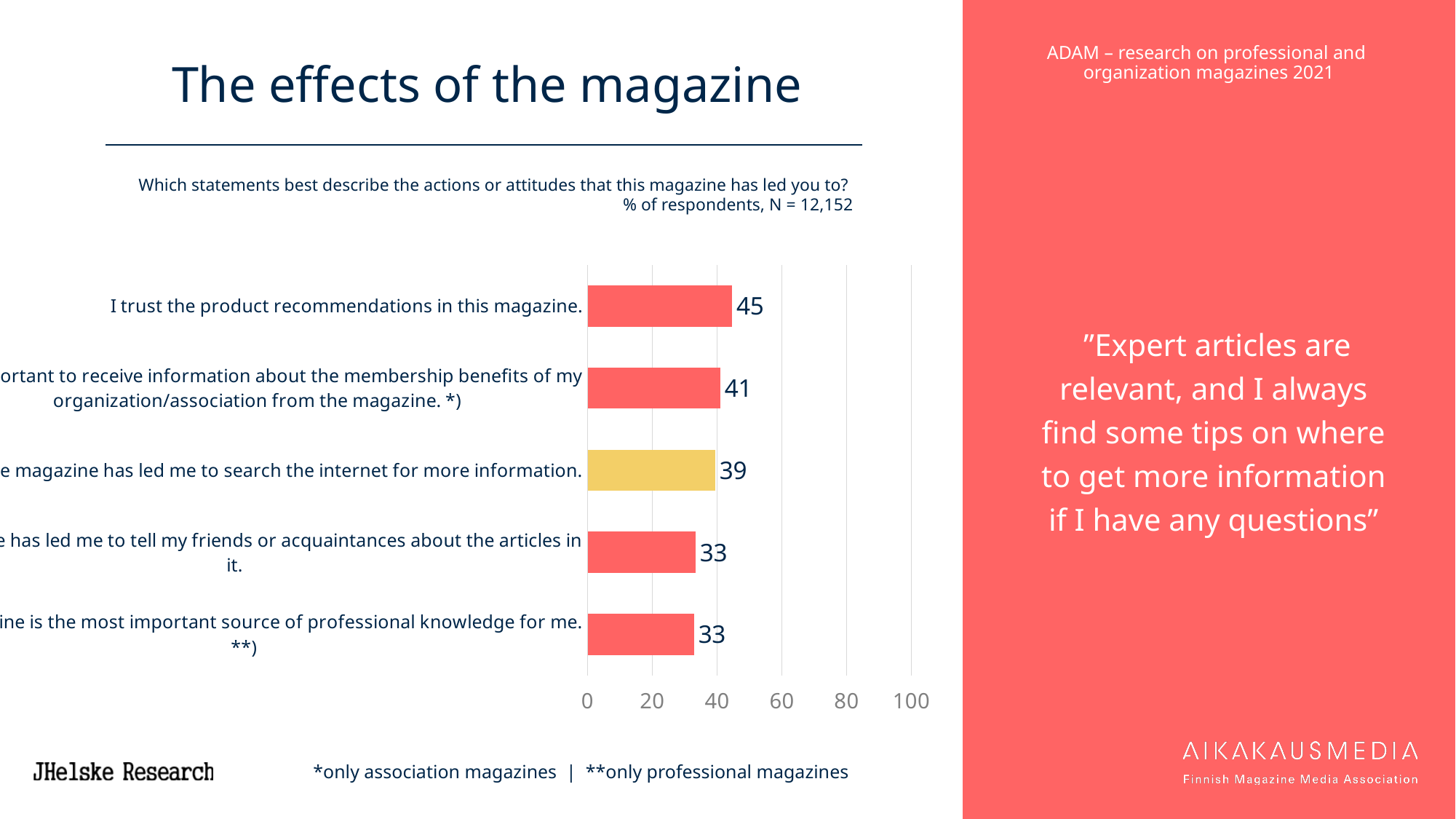
What is the number of respondents (N) stated for the chart? 12,152 What value is shown for the statement about the magazine being the most important source of professional knowledge? 33 How many statements are plotted in the chart? 5 Which bar is coloured differently (yellow) from the others? The magazine has led me to search the internet for more information. What type of chart is shown on the slide? Bar chart Is the value for trusting product recommendations greater or less than 40? greater What percentage of respondents say they trust the product recommendations in this magazine? 45 What is the difference between the value for trusting product recommendations and the value for telling friends or acquaintances about the articles? 12 What value is shown for the statement about the magazine leading respondents to search the internet for more information? 39 What value is shown for the statement about receiving information about the membership benefits of the organization/association from the magazine? 41 Which statement has the highest value in the chart? I trust the product recommendations in this magazine. Which is larger: the value for receiving information about membership benefits or the value for searching the internet for more information? Receiving information about membership benefits